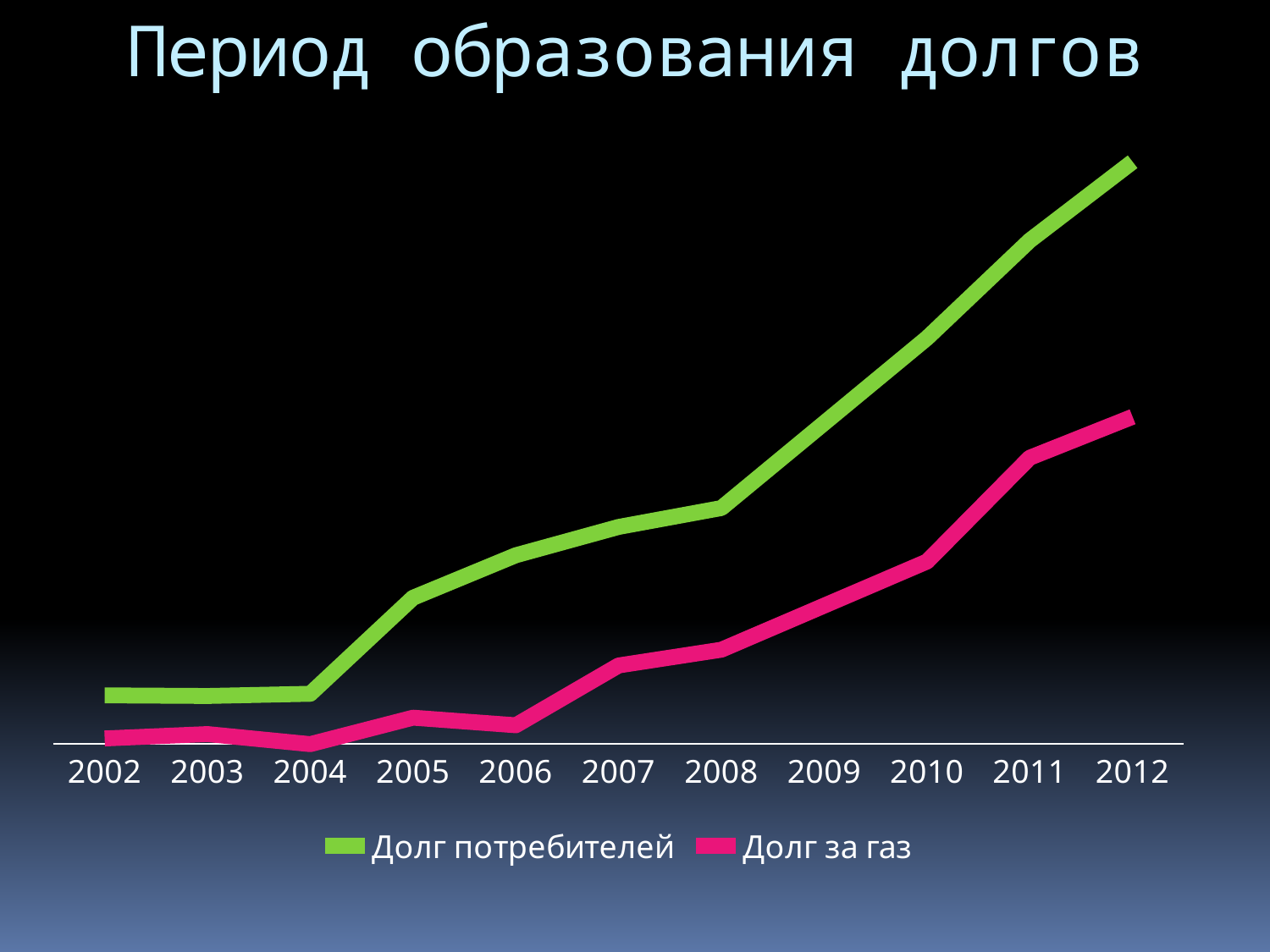
Which series is drawn in green? Долг потребителей In which year does Долг потребителей reach its highest value? 2012 Do the values for Долг потребителей rise or fall from 2004 to 2012? rise In 2012, which series has the higher value, Долг потребителей or Долг за газ? Долг потребителей Do the values for Долг за газ rise or fall from 2006 to 2012? rise What is the title of the chart? Период образования долгов How many years are shown along the x axis? 11 How many series does the legend list? 2 What kind of chart is shown on the slide? line chart Which year is the first x-axis category on the chart? 2002 In 2008, which series has the higher value, Долг потребителей or Долг за газ? Долг потребителей In which year does Долг за газ reach its highest value? 2012